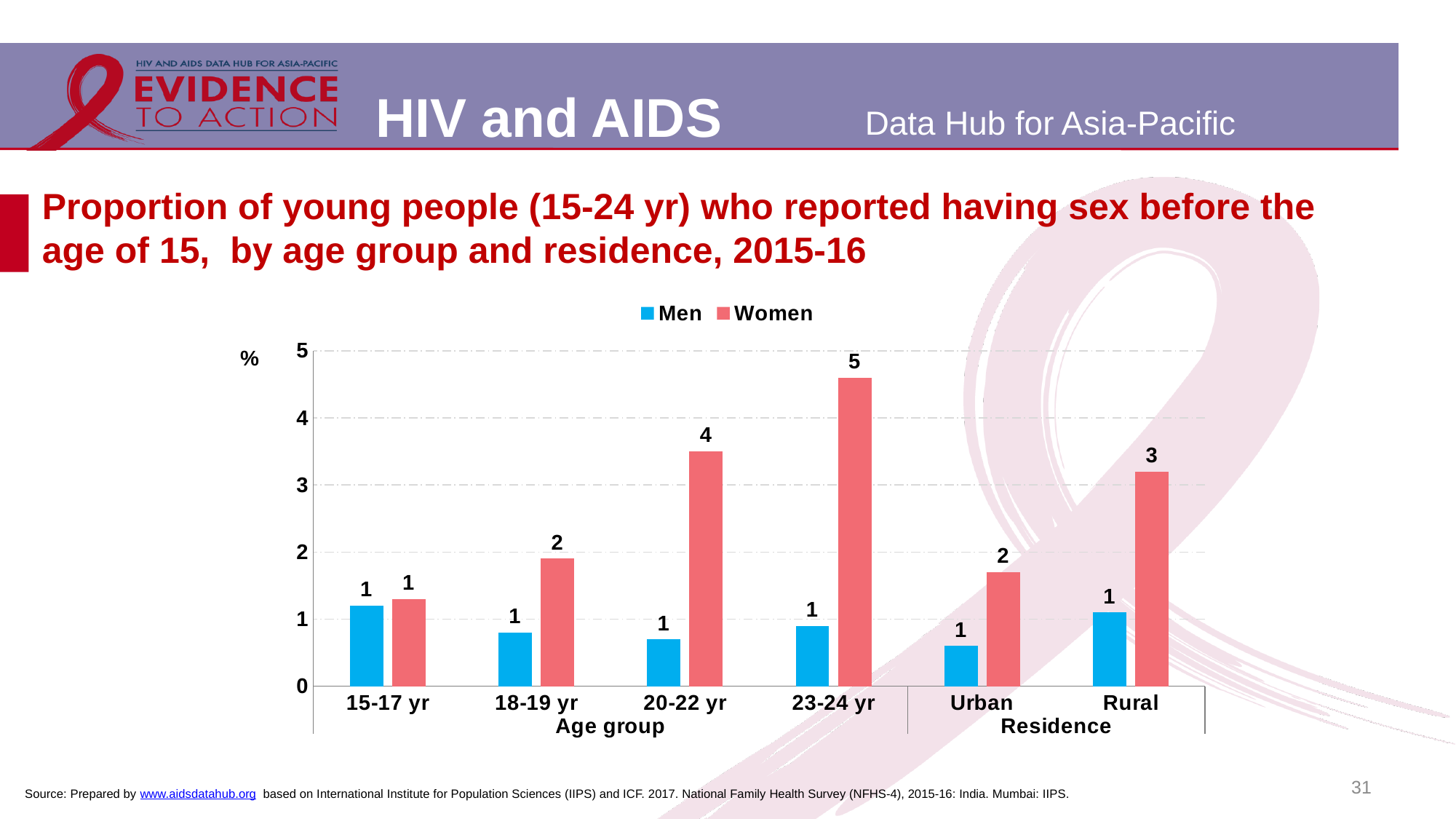
Which category has the highest value for Women? 23-24 yr What is the labelled value for Men in the 15-17 yr age group? 1 What is the labelled value for Women in the Rural category? 3 What is the labelled value for Women in the 20-22 yr age group? 4 Which category has the lowest value for Women? 15-17 yr Which is larger for Women: the 23-24 yr bar or the 20-22 yr bar? 23-24 yr What type of chart is shown on the slide? bar chart How many series does the legend list? 2 Do the Women values rise or fall across the age groups from 15-17 yr to 23-24 yr? rise What is the labelled value for Women in the 23-24 yr age group? 5 How many categories are shown along the x axis? 6